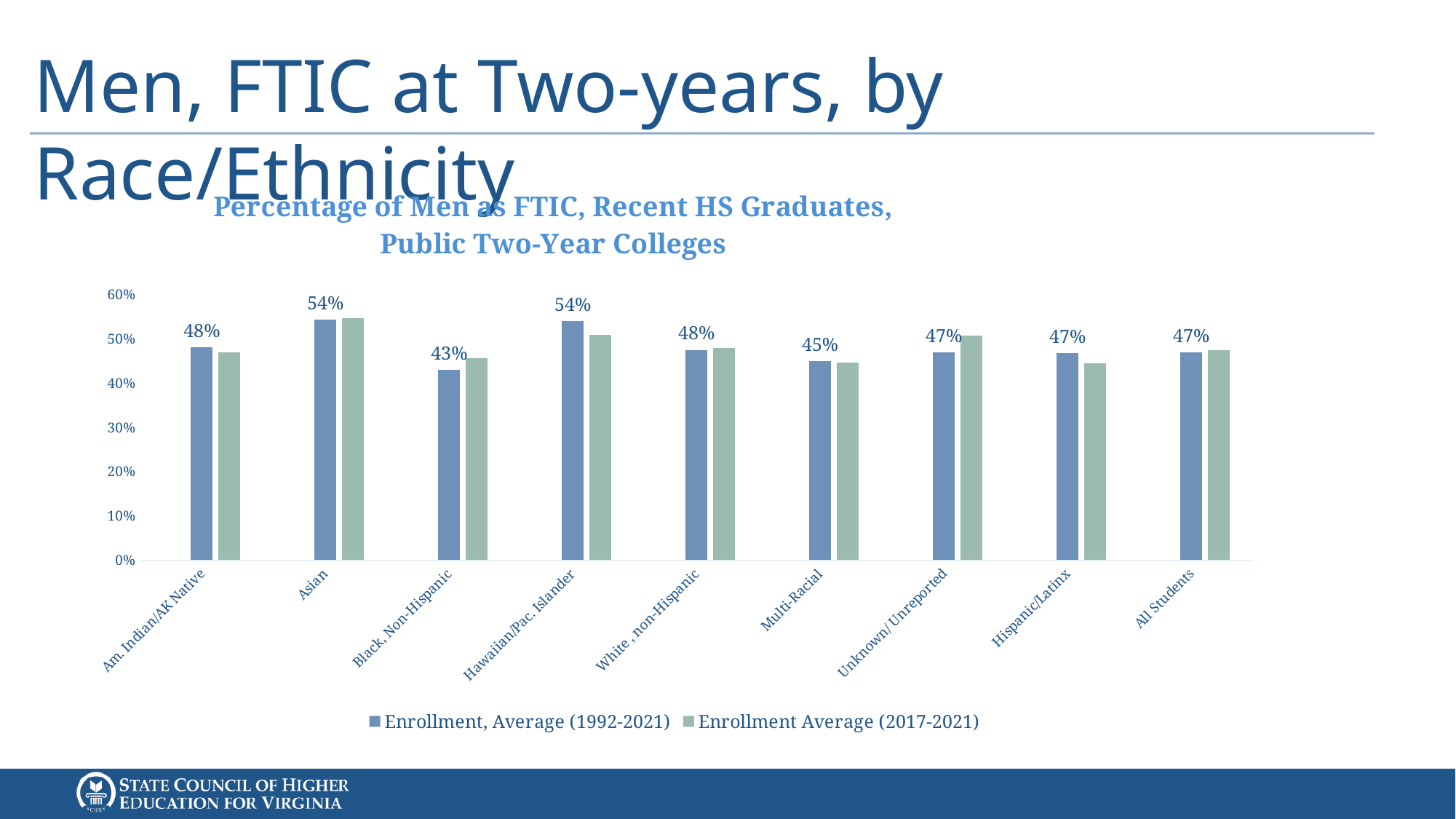
How many series does the legend list? 2 What is the Enrollment, Average (1992-2021) value for Asian? 54% How many race/ethnicity categories are shown on the x axis? 9 What is the Enrollment, Average (1992-2021) value for All Students? 47% What is the Enrollment, Average (1992-2021) value for Multi-Racial? 45% What kind of chart is shown on the slide? Bar chart Is the Enrollment Average (2017-2021) value for Hispanic/Latinx greater or less than 50%? less What is the difference between the Enrollment, Average (1992-2021) values for Asian and Black, Non-Hispanic? 11 percentage points Which has the larger Enrollment, Average (1992-2021) value, Hawaiian/Pac. Islander or Multi-Racial? Hawaiian/Pac. Islander Which category has the lowest Enrollment, Average (1992-2021) value? Black, Non-Hispanic What is the Enrollment, Average (1992-2021) value for Black, Non-Hispanic? 43% Is the Enrollment Average (2017-2021) value for Asian greater or less than 50%? greater